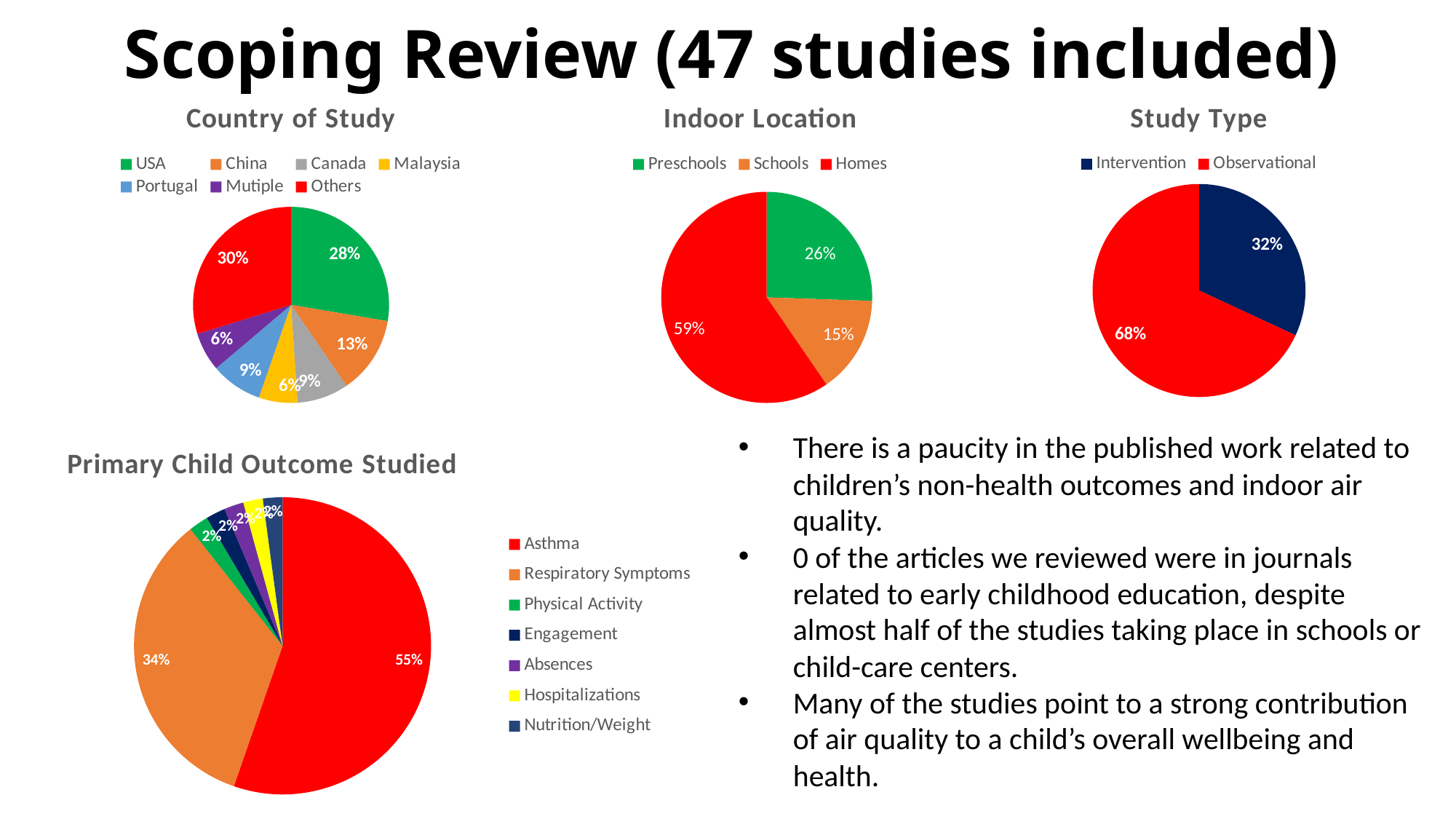
In the Indoor Location chart, what share of studies took place in Homes? 59% In the Study Type chart, what share of studies are Intervention studies? 32% What kind of chart is the Study Type chart? Pie chart In the Primary Child Outcome Studied chart, what share of studies focused on Respiratory Symptoms? 34% In the Indoor Location chart, what is the difference between the Preschools share and the Schools share? 11% In the Country of Study chart, how many categories does the legend list? 7 In the Country of Study chart, what share of studies is from the USA? 28% In the Country of Study chart, what share of studies is from China? 13% In the Indoor Location chart, which location has the smallest share? Schools In the Study Type chart, which is larger, Intervention or Observational? Observational In the Primary Child Outcome Studied chart, which outcome has the largest share? Asthma In the Country of Study chart, which category has the largest share? Others